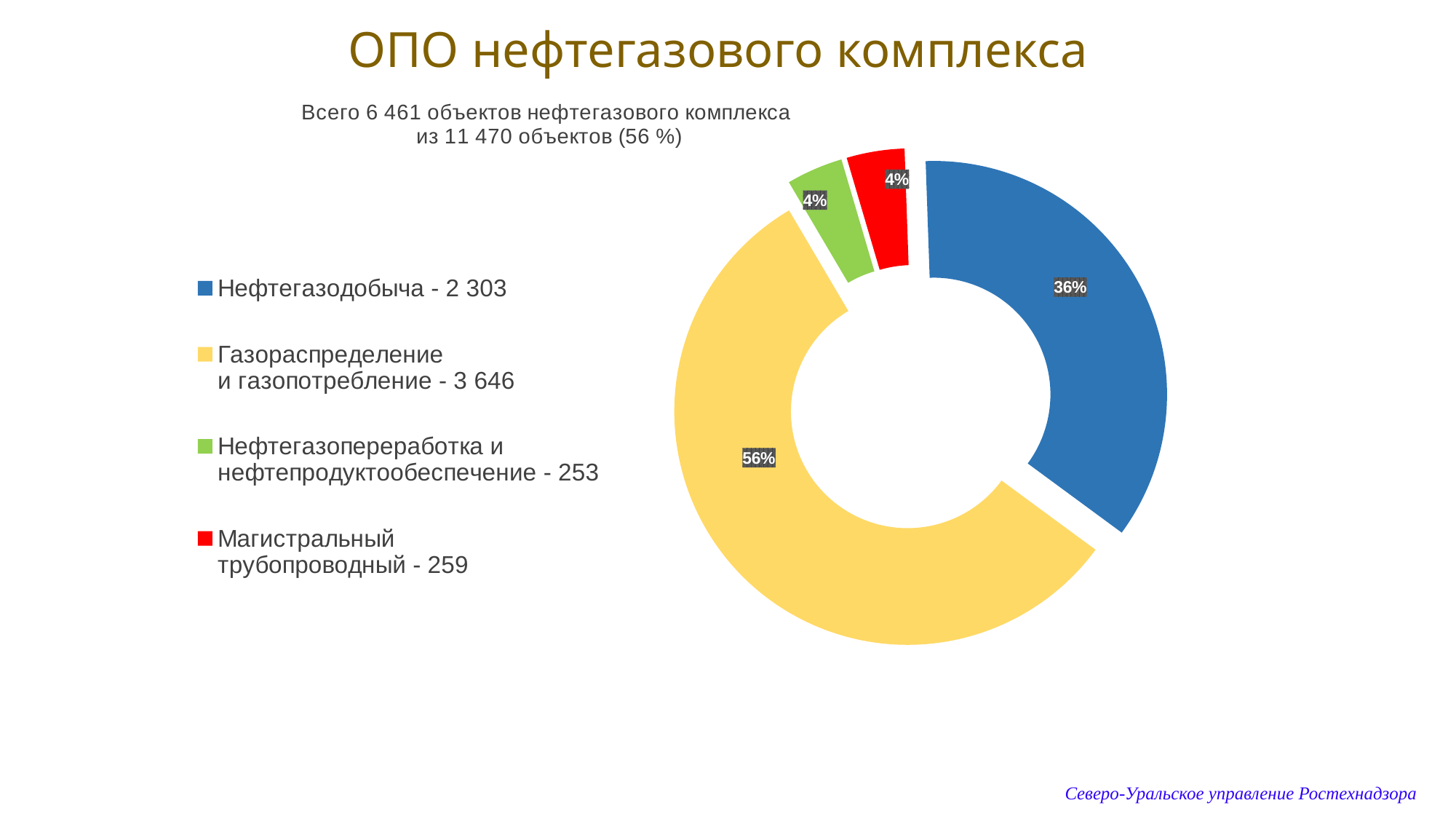
Which has more objects: Магистральный трубопроводный or Нефтегазопереработка и нефтепродуктообеспечение? Магистральный трубопроводный What share of the doughnut chart does Магистральный трубопроводный account for? 4% How many objects does the legend give for Нефтегазопереработка и нефтепродуктообеспечение? 253 Which category has the smallest number of objects according to the legend? Нефтегазопереработка и нефтепродуктообеспечение How many objects does the legend give for Газораспределение и газопотребление? 3 646 What share of the doughnut chart does Газораспределение и газопотребление account for? 56% What share of the doughnut chart does Нефтегазодобыча account for? 36% Which category has the largest share of the doughnut chart? Газораспределение и газопотребление What is the difference in the number of objects between Газораспределение и газопотребление and Нефтегазодобыча? 1 343 How many categories are shown in the chart? 4 What type of chart is shown on the slide? Doughnut (pie) chart How many objects does the legend give for Нефтегазодобыча? 2 303